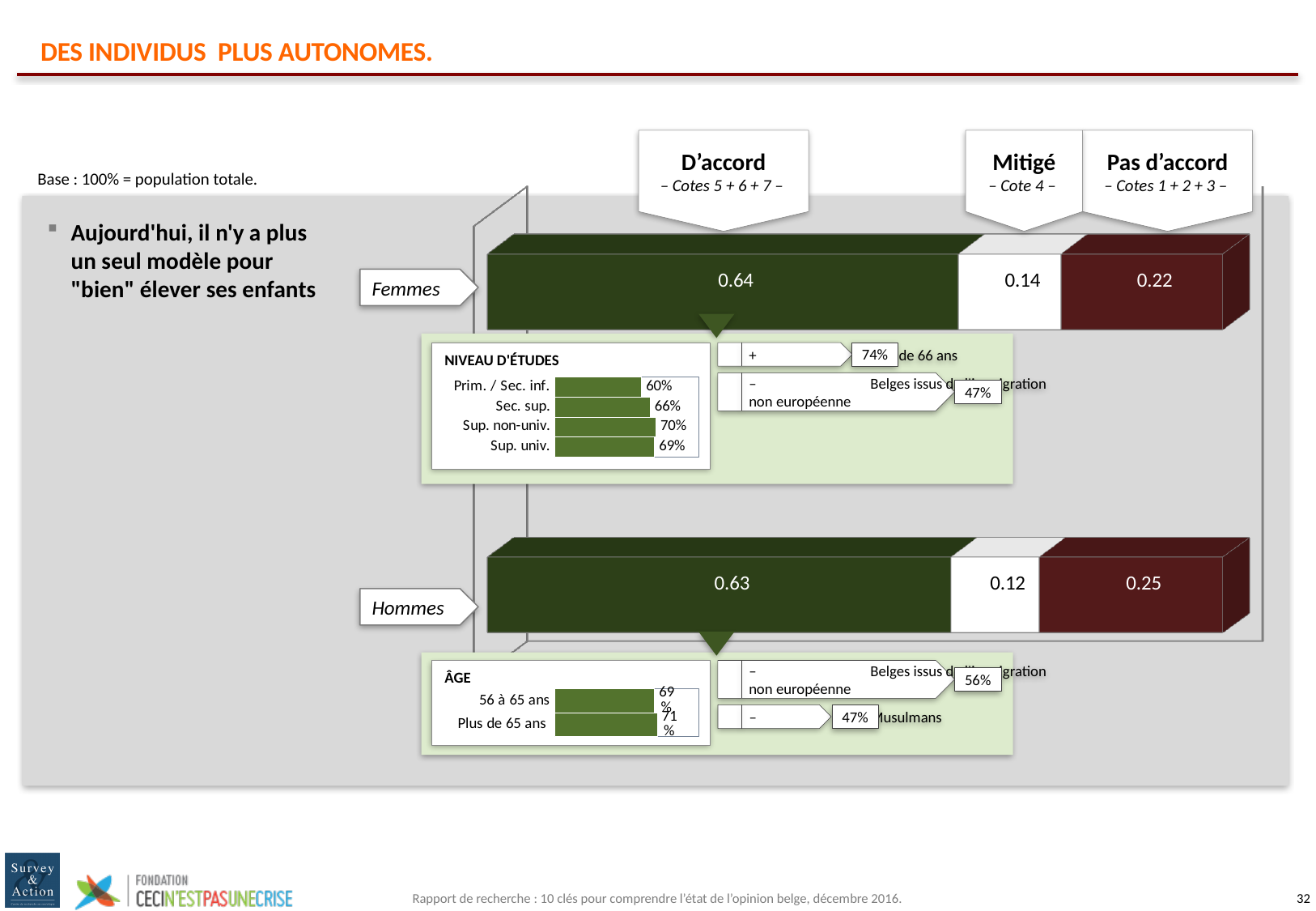
In the 'NIVEAU D'ÉTUDES' chart, which category has the lowest value? Prim. / Sec. inf. In the main stacked bar chart, what is the 'D'accord' value for Femmes? 0.64 In the main stacked bar chart, what is the 'Pas d'accord' value for Hommes? 0.25 In the 'ÂGE' chart, what is the value for Plus de 65 ans? 71% In the 'NIVEAU D'ÉTUDES' chart, which category has the highest value? Sup. non-univ. In the 'NIVEAU D'ÉTUDES' chart, what is the value for Sec. sup.? 66% In the main stacked bar chart, what is the 'Mitigé' value for Femmes? 0.14 In the main stacked bar chart, which group has the larger 'Pas d'accord' value, Femmes or Hommes? Hommes In the main stacked bar chart, what is the difference between the 'Mitigé' values for Femmes and Hommes? 0.02 In the main stacked bar chart, what is the total of the three segments for the Hommes bar? 1.00 How many categories are shown in the 'NIVEAU D'ÉTUDES' chart? 4 What kind of chart is the main chart showing Femmes and Hommes? Stacked bar chart